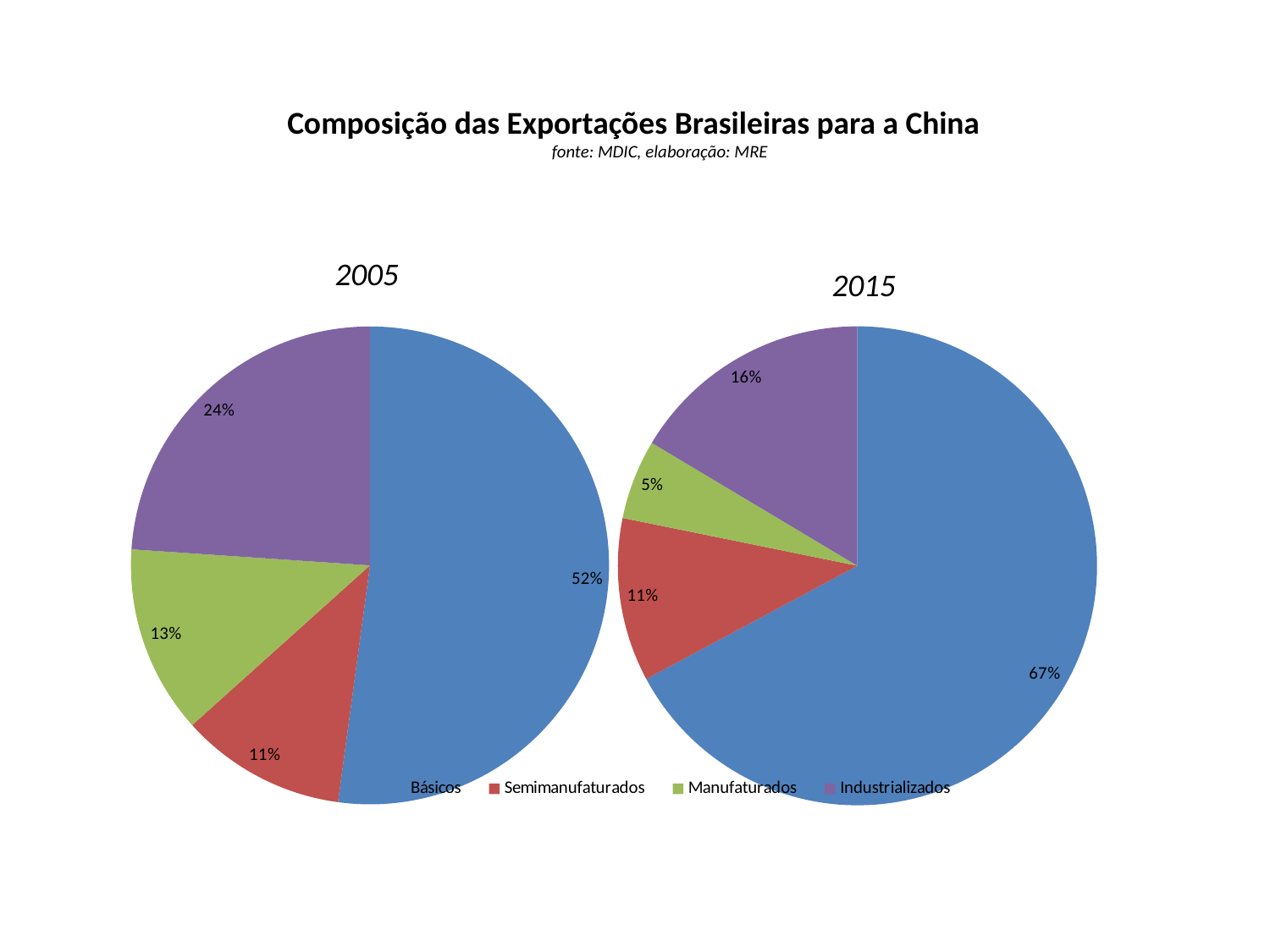
In the 2005 pie chart, what is the share of Industrializados? 24% In the 2005 pie chart, which category has the largest share? Básicos What is the difference between the share of Básicos in the 2015 pie chart and in the 2005 pie chart? 15 percentage points In the 2015 pie chart, what is the share of Manufaturados? 5% In the 2015 pie chart, what share do Básicos represent? 67% How many categories does the legend list? 4 Is the share of Industrializados larger in the 2005 pie chart or in the 2015 pie chart? 2005 In the 2005 pie chart, which category has the smallest share? Semimanufaturados What type of chart is used on this slide? Pie chart In the 2015 pie chart, which category has the smallest share? Manufaturados In the 2005 pie chart, what share do Básicos represent? 52% What is the title of the slide's chart? Composição das Exportações Brasileiras para a China